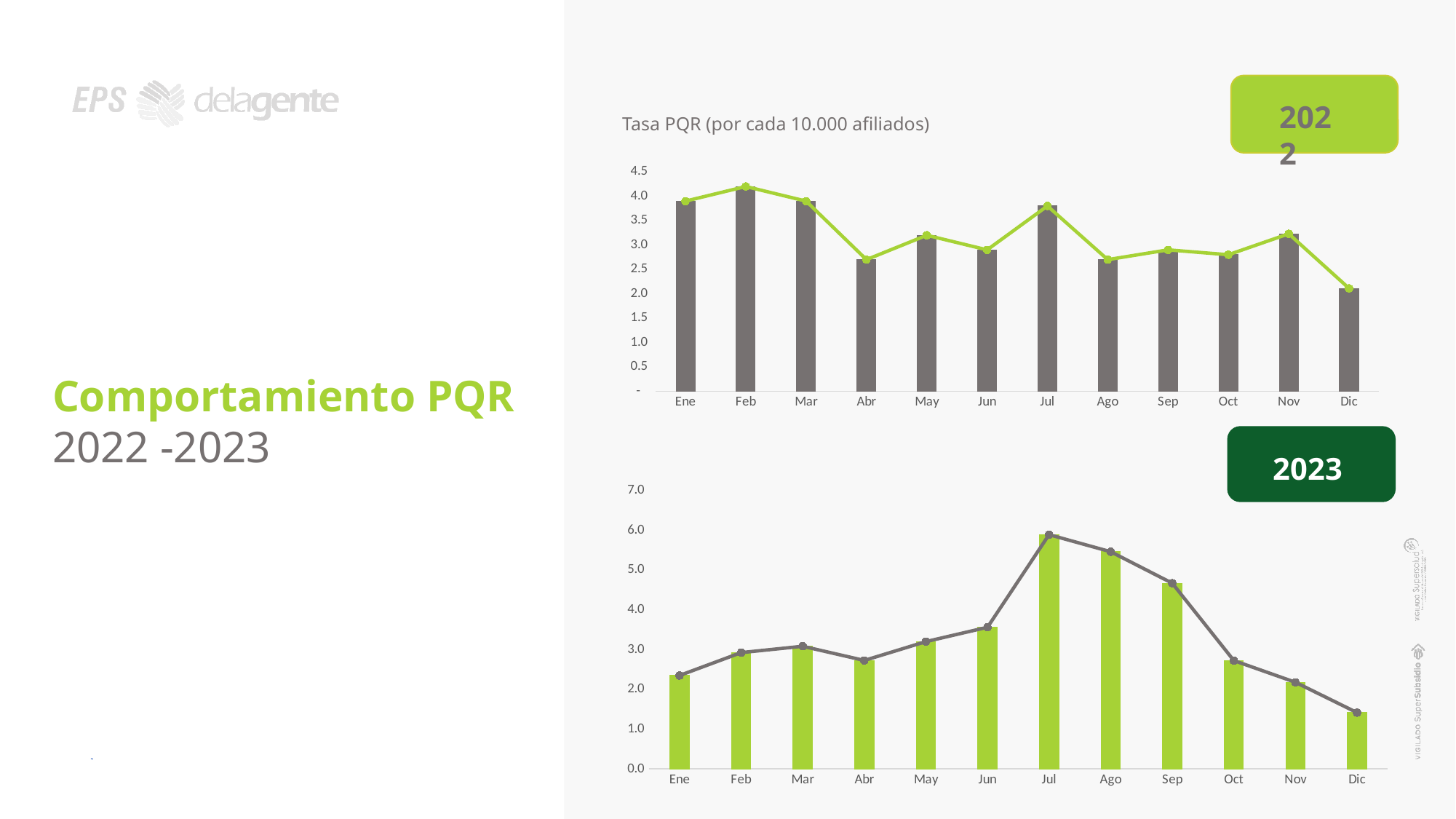
In the top chart (2022), which month has the highest Tasa PQR? Feb In the bottom chart (2023), do the values rise or fall from Sep to Dic? fall In the top chart (2022), which month has the lowest Tasa PQR? Dic In the bottom chart (2023), is the value for Jul greater or less than 5.0? greater In the top chart (2022), is the value for Dic greater or less than 2.5? less In the top chart (2022), is the value for Feb greater or less than 4.0? greater In the bottom chart (2023), which month has the lowest value? Dic How many months are plotted in the top chart (2022)? 12 What is the title of the top chart? Tasa PQR (por cada 10.000 afiliados) In the top chart (2022), which is larger, the value for Jul or the value for Ago? Jul In the bottom chart (2023), which month has the highest value? Jul